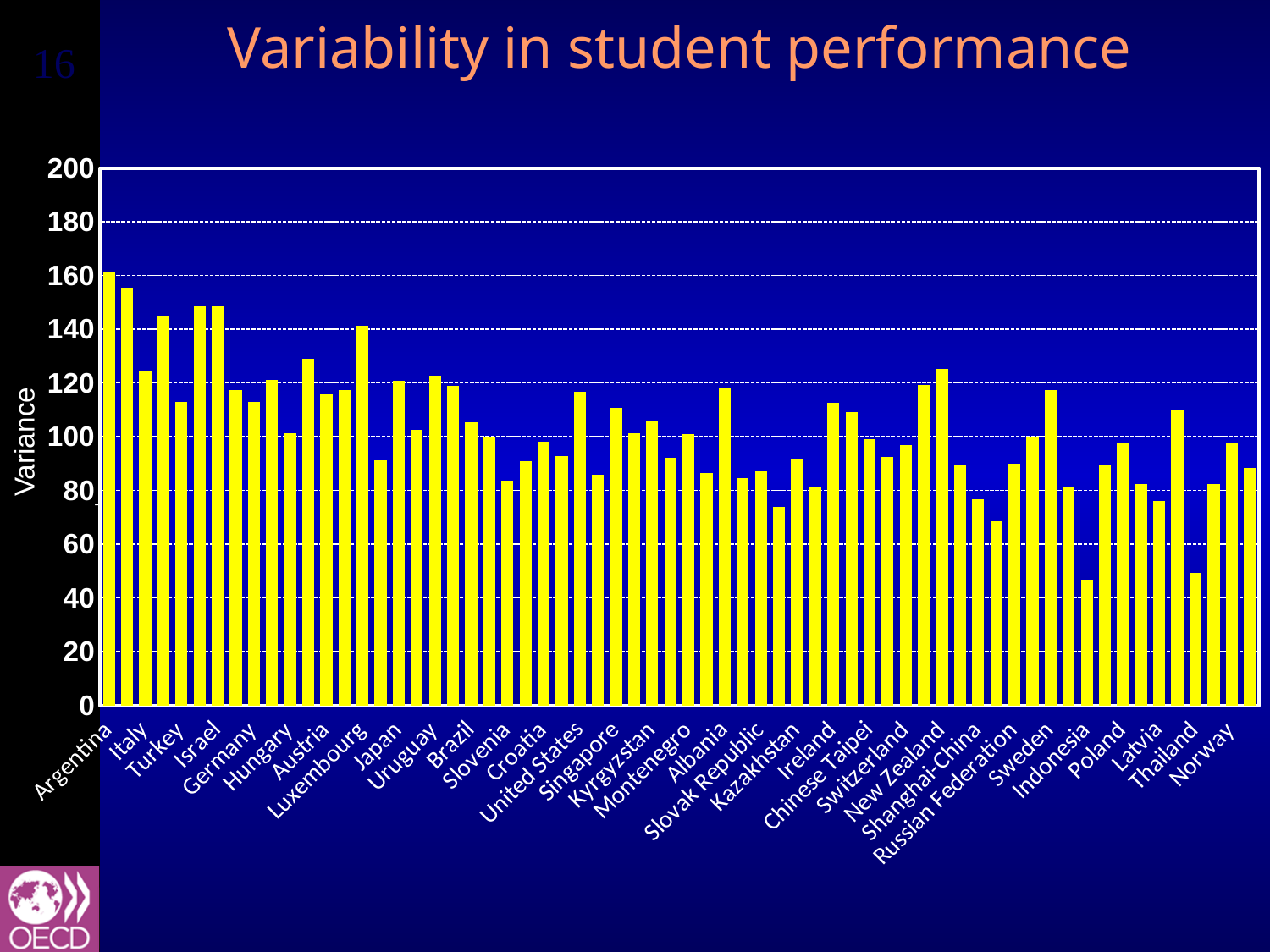
Is the value for Argentina greater or less than 140? greater Which has the larger variance, Israel or Indonesia? Israel Is the value for Indonesia greater or less than 60? less Which has the larger variance, Argentina or Norway? Argentina Which country has the highest variance in the chart? Argentina What kind of chart is shown on the slide? bar chart Is the value for Norway greater or less than 120? less What is the title of the chart? Variability in student performance What is the highest value shown on the vertical axis? 200 What is the label on the vertical axis of the chart? Variance Do the variance values generally rise or fall from left to right across the chart? fall